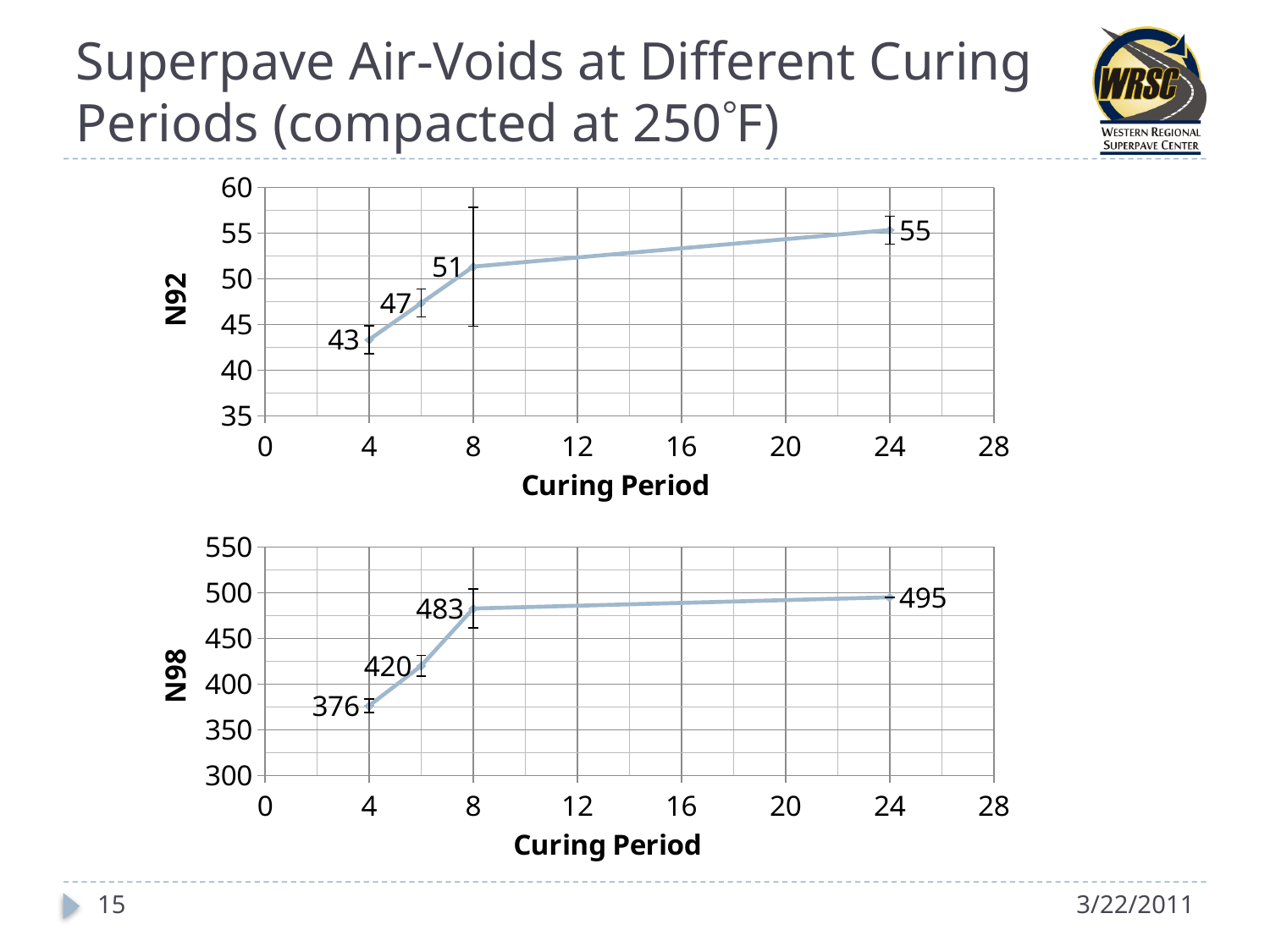
In the top chart (N92), what is the value at a curing period of 24? 55 In the top chart (N92), do the values rise or fall as the curing period increases? Rise In the bottom chart (N98), what is the value at a curing period of 4? 376 In the bottom chart (N98), which curing period has the lowest value? 4 In the bottom chart (N98), what is the value at a curing period of 8? 483 How many data points are plotted in the top chart (N92)? 4 What kind of chart is the bottom chart (N98)? Line chart In the bottom chart (N98), which is larger, the value at curing period 6 or at curing period 24? 24 In the top chart (N92), which curing period has the highest value? 24 In the bottom chart (N98), what is the difference between the values at curing periods 8 and 6? 63 In the top chart (N92), what is the difference between the values at curing periods 24 and 4? 12 In the top chart (N92), what is the value at a curing period of 4? 43